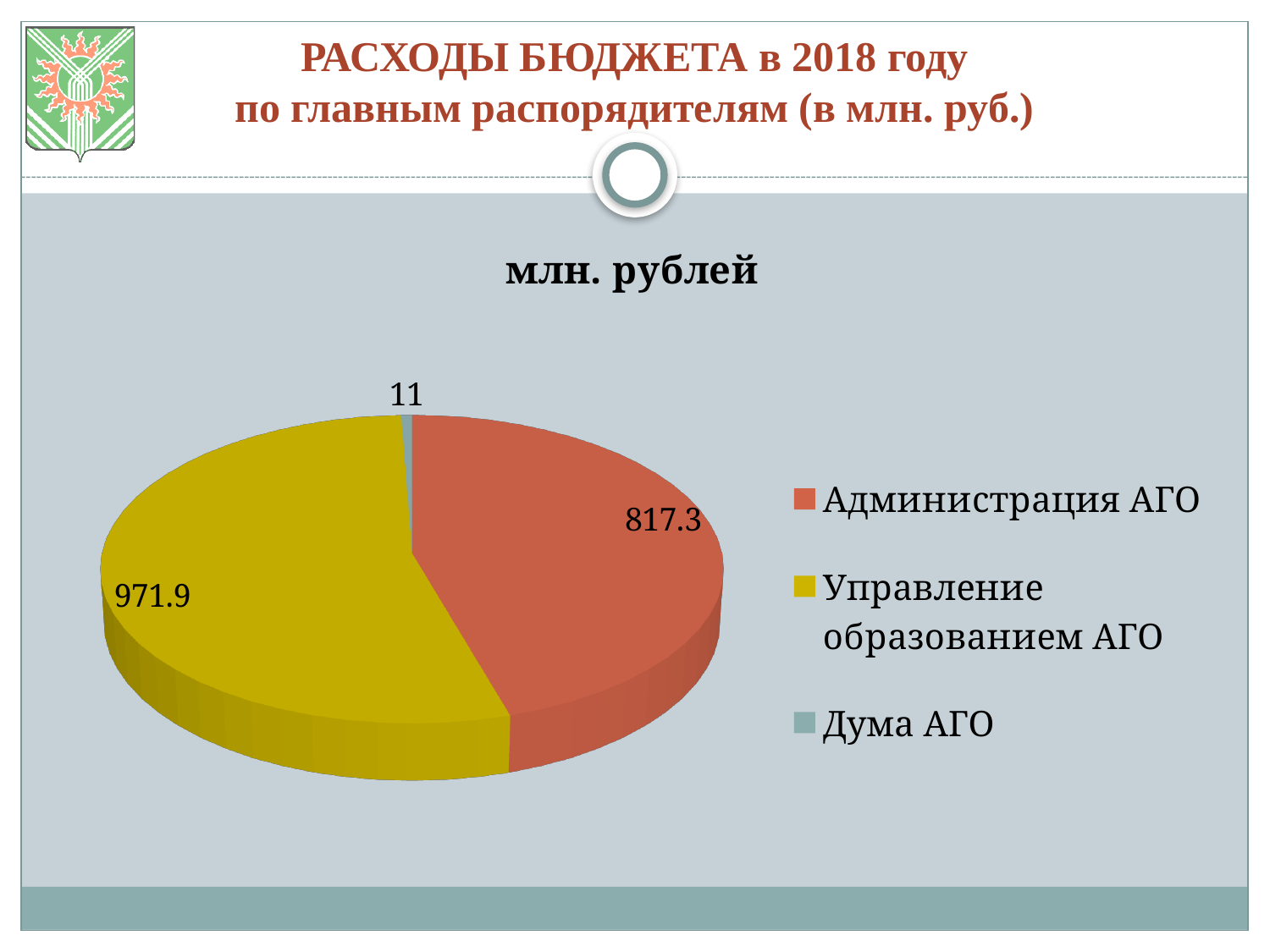
What is the value for Управление образованием АГО in the pie chart? 971.9 What is the value for Администрация АГО in the pie chart? 817.3 What is the total of all slices in the pie chart? 1800.2 What is the title of the chart on the slide? млн. рублей What is the difference between the values for Администрация АГО and Дума АГО? 806.3 How many categories are shown in the pie chart? 3 Which is larger, the value for Администрация АГО or the value for Управление образованием АГО? Управление образованием АГО What is the value for Дума АГО in the pie chart? 11 What kind of chart is shown on the slide? Pie chart Which category has the largest slice in the pie chart? Управление образованием АГО Which category has the smallest slice in the pie chart? Дума АГО What is the difference between the values for Управление образованием АГО and Администрация АГО? 154.6